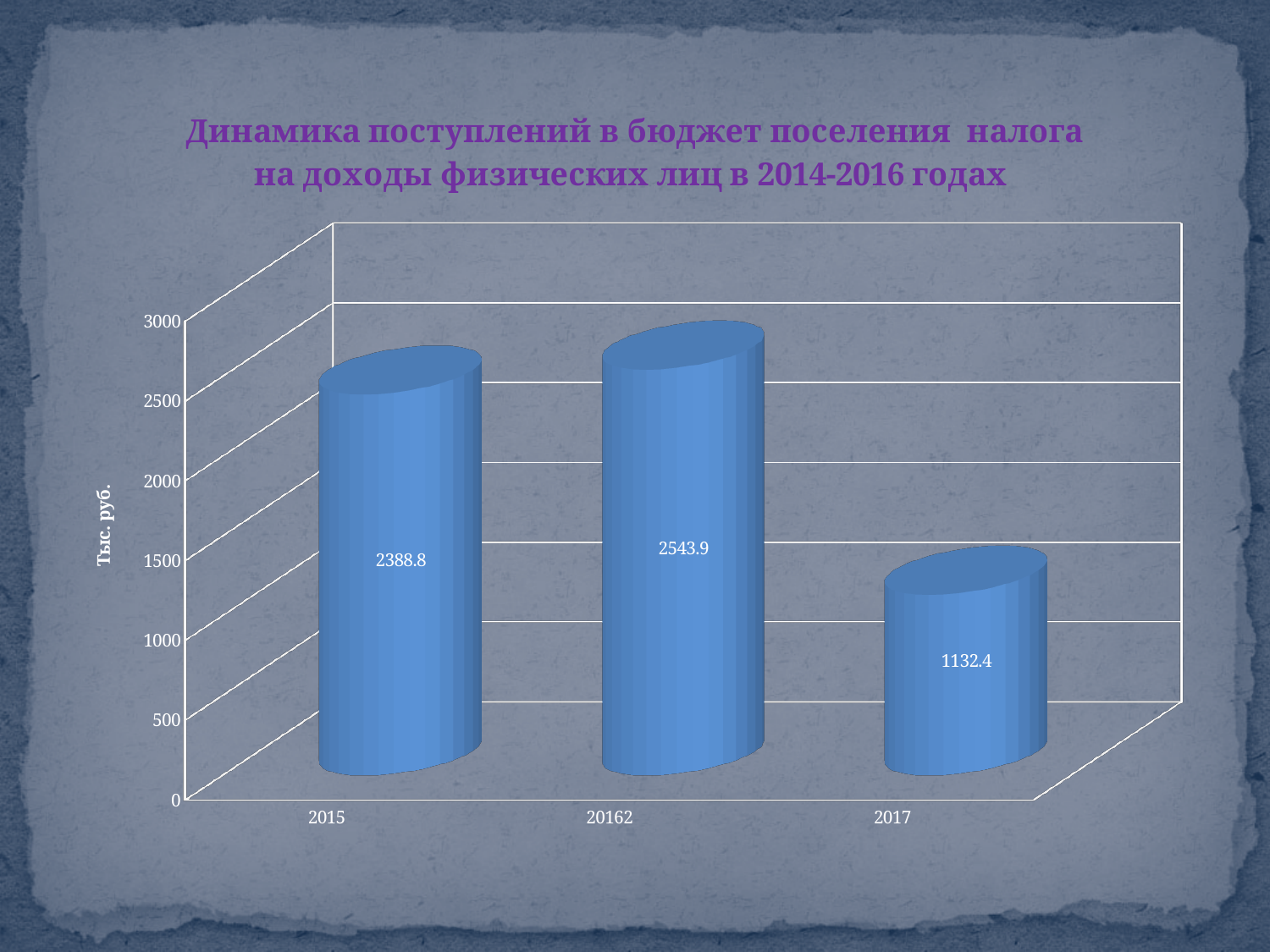
Which is larger, the value for 2015 or the value for 2017? 2015 What kind of chart is shown on the slide? bar chart Is the value for 2017 greater or less than 1500? less Which category has the lowest value? 2017 What is the value for 2017? 1132.4 Which category has the highest value? 20162 What is the label on the vertical axis? Тыс. руб. What is the difference between the values for 20162 and 2015? 155.1 What is the difference between the values for 2015 and 2017? 1256.4 What is the value for 2015? 2388.8 How many categories are shown on the x axis? 3 What is the value for the category labelled 20162? 2543.9